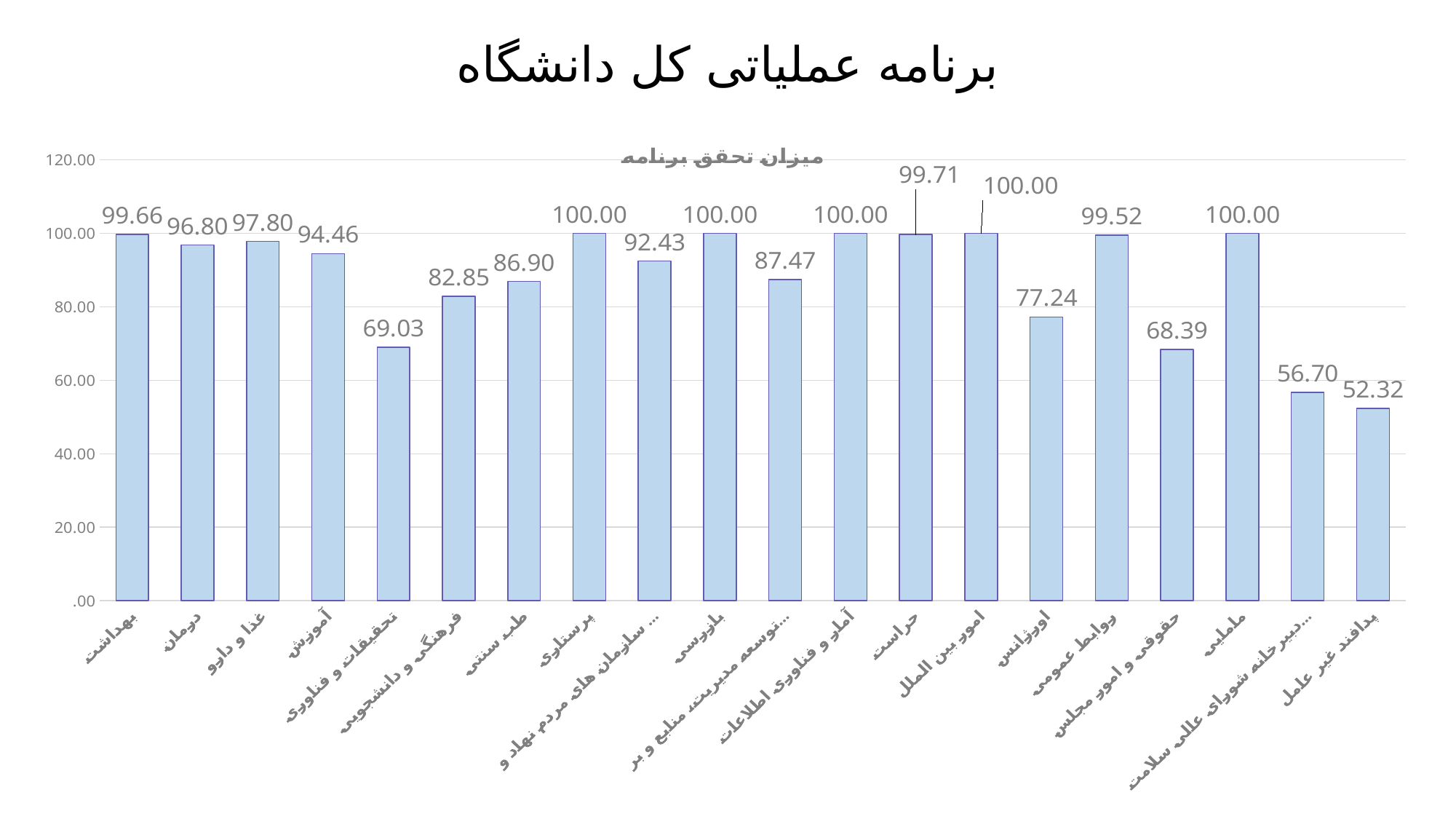
What is the difference between the values for حقوقی و امور مجلس and پدافند غیر عامل? 16.07 What is the value for بهداشت? 99.66 Which category has the lowest value? پدافند غیر عامل What kind of chart is shown on the slide? bar chart Which is larger, the value for طب سنتی or the value for فرهنگی و دانشجویی? طب سنتی What is the difference between the values for درمان and غذا و دارو? 1.00 How many categories are shown on the x axis? 20 What is the value for حراست? 99.71 Is the value for دبیرخانه شورای عالی سلامت greater or less than 60.00? less What is the title of the chart? میزان تحقق برنامه What is the value for تحقیقات و فناوری? 69.03 What is the value for اورژانس? 77.24